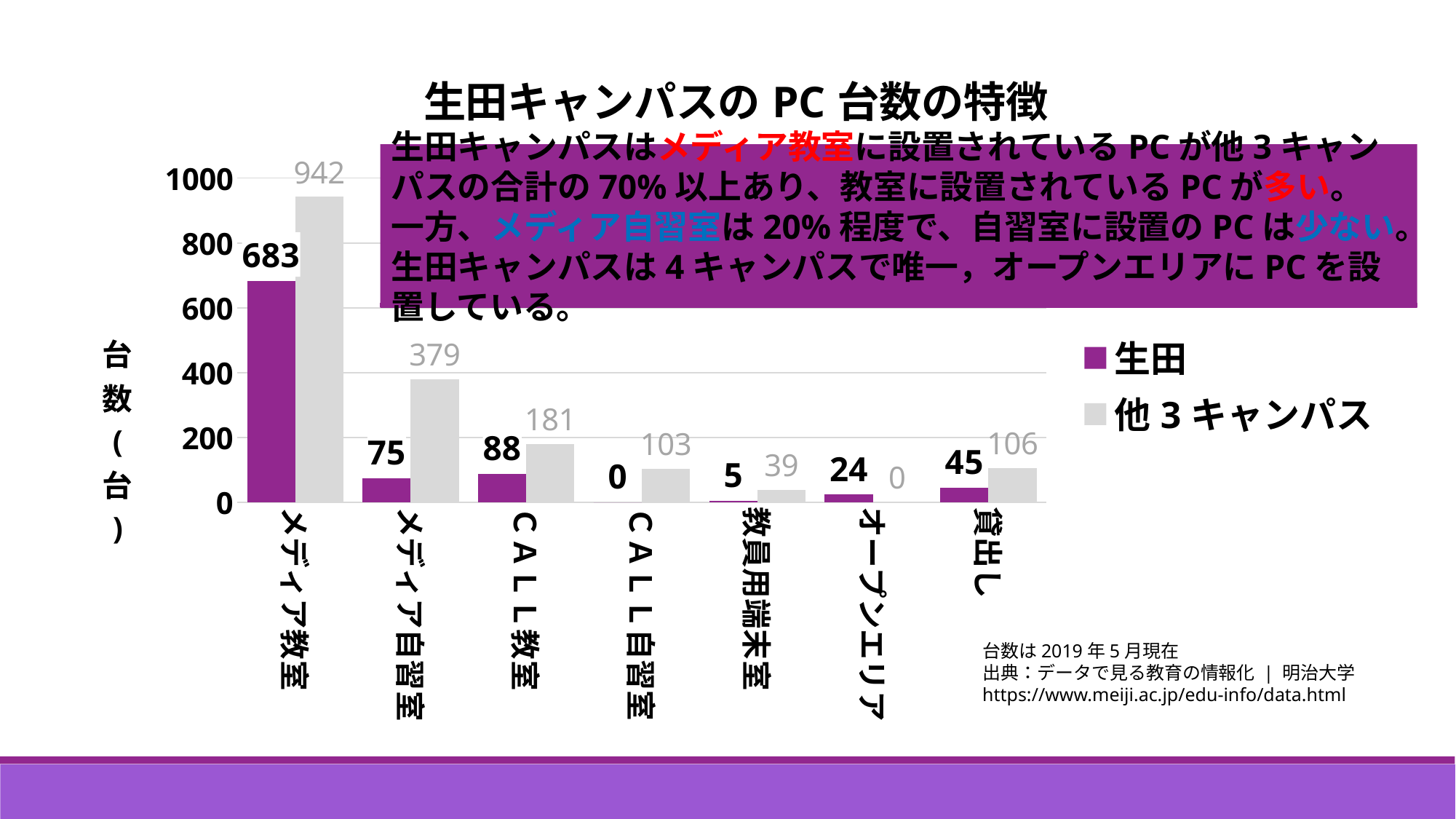
Which is larger in the CALL教室 category, 生田 or 他3キャンパス? 他3キャンパス What is the difference between 他3キャンパス and 生田 in the メディア教室 category? 259 How many categories are shown on the x axis? 7 What is the value for 生田 in the オープンエリア category? 24 Which category has the lowest value for 生田? CALL自習室 What kind of chart is shown on the slide? bar chart What is the value for 他3キャンパス in the 貸出し category? 106 What is the label of the y axis? 台数（台） How many series does the legend list? 2 Which category has the highest value for 他3キャンパス? メディア教室 What is the value for 生田 in the メディア教室 category? 683 What is the value for 他3キャンパス in the メディア自習室 category? 379